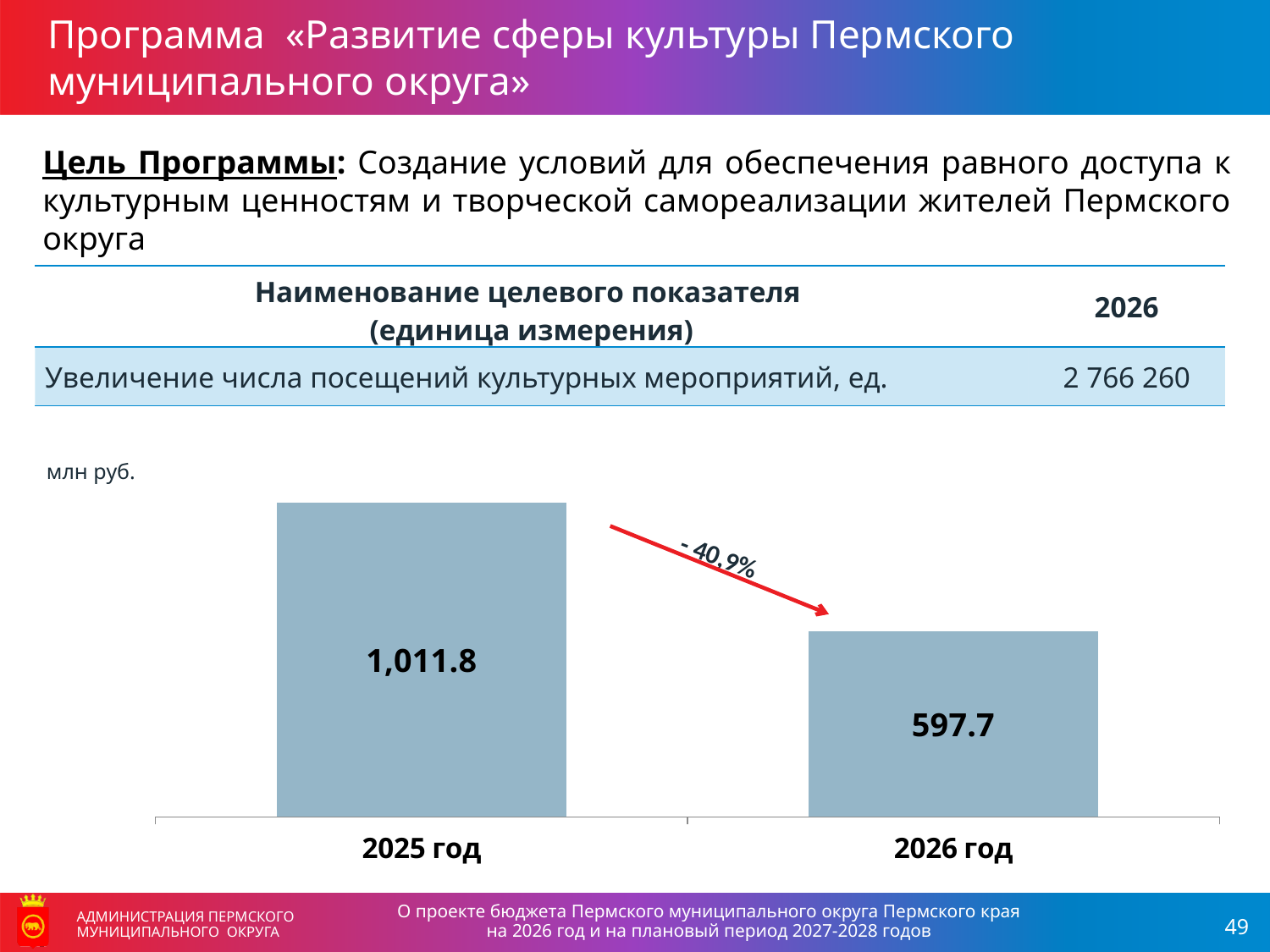
What unit of measurement is indicated for the chart values? млн руб. Do the values rise or fall from 2025 год to 2026 год? fall What is the value for 2026 год on the chart? 597.7 Which is larger, the value for 2025 год or the value for 2026 год? 2025 год What kind of chart is shown on the slide? bar chart What is the value for 2025 год on the chart? 1,011.8 Which year has the lowest value on the chart? 2026 год How many bars are shown on the chart? 2 What percentage change is shown by the arrow annotation on the chart? -40.9% Which year has the highest value on the chart? 2025 год What is the difference between the values for 2025 год and 2026 год? 414.1